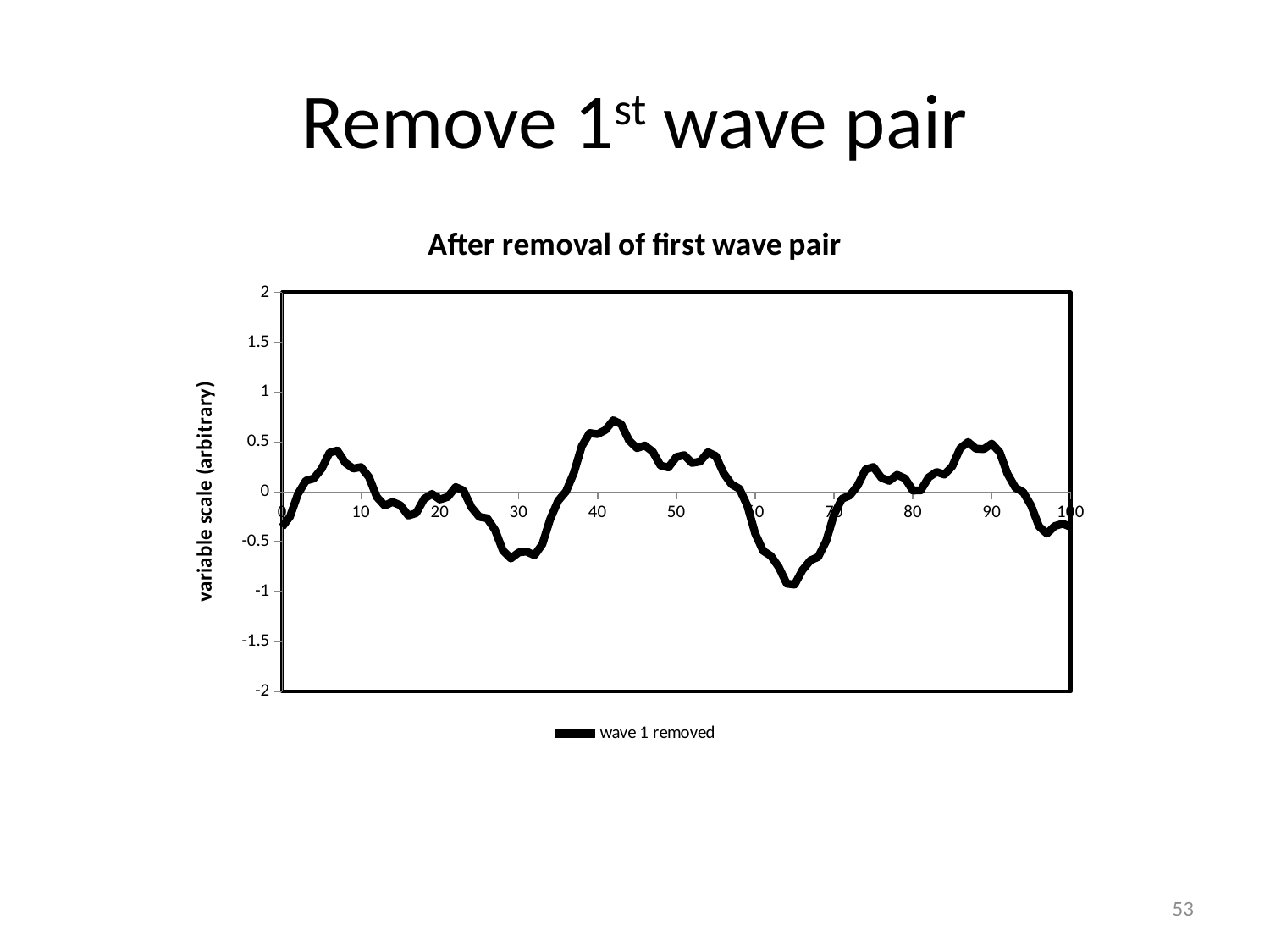
How many series does the legend list? 1 What kind of chart is shown on the slide? line chart Is the value of the line at x = 42 greater or less than 0.5? greater Is the value of the line at x = 42 larger or smaller than the value at x = 65? larger What is the title of the chart? After removal of first wave pair Is the value of the line at x = 30 greater or less than -0.5? less What is the label of the vertical axis? variable scale (arbitrary) Is the value of the line at x = 6 greater or less than 0? greater Does the line rise or fall between x = 30 and x = 42? rise Does the line rise or fall between x = 60 and x = 65? fall